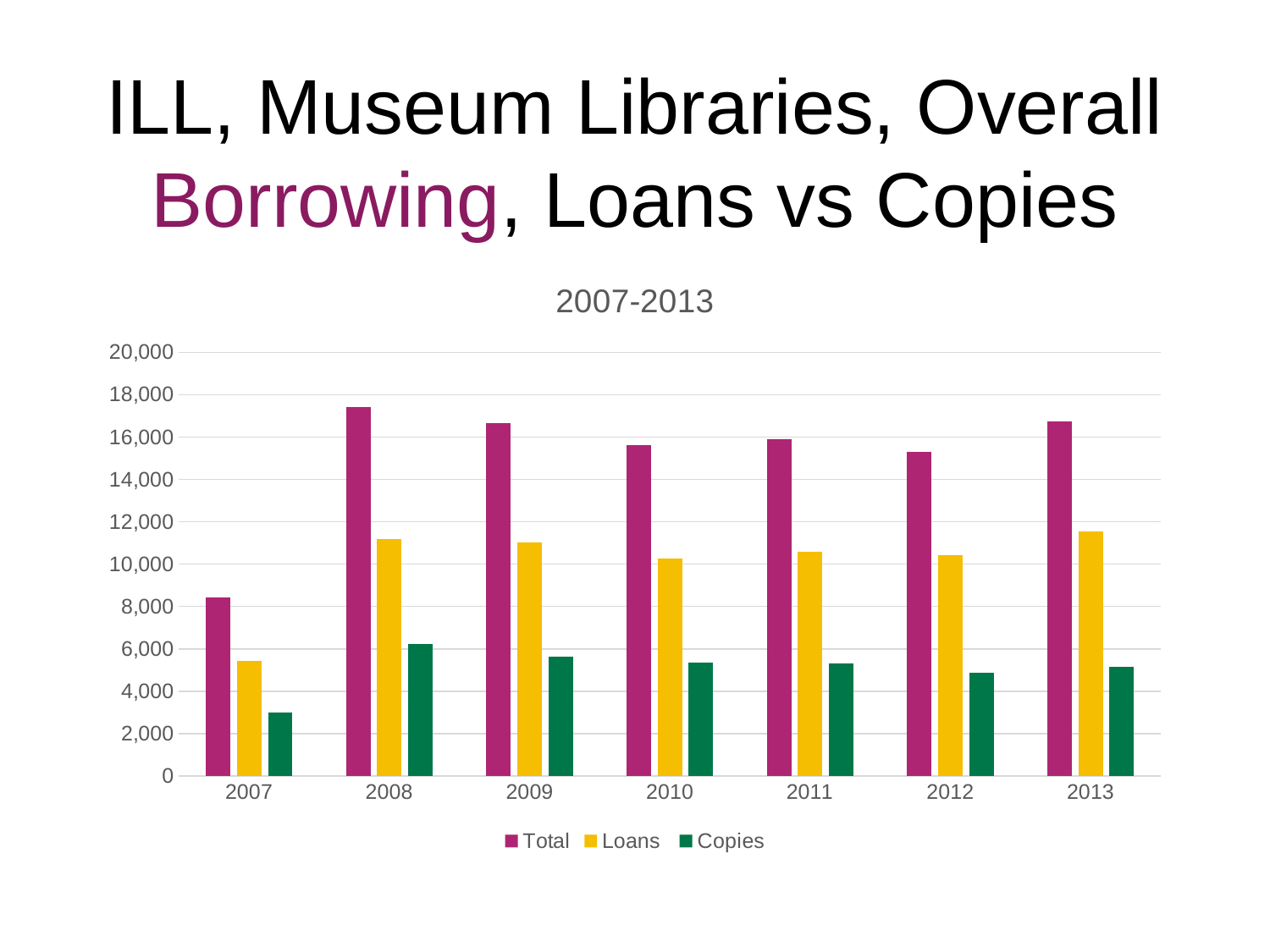
What kind of chart is shown on the slide? bar chart Is the Copies value for 2008 greater or less than 6,000? greater Is the Loans value for 2013 greater or less than 10,000? greater What is the subtitle shown above the chart? 2007-2013 Which year has the highest Total value? 2008 How many series does the legend list? 3 Which year has the lowest Copies value? 2007 How many years are shown on the x axis? 7 Which year has the lowest Total value? 2007 Is the Total value for 2007 greater or less than 10,000? less Which is larger in 2010, Loans or Copies? Loans Which year has the highest Copies value? 2008